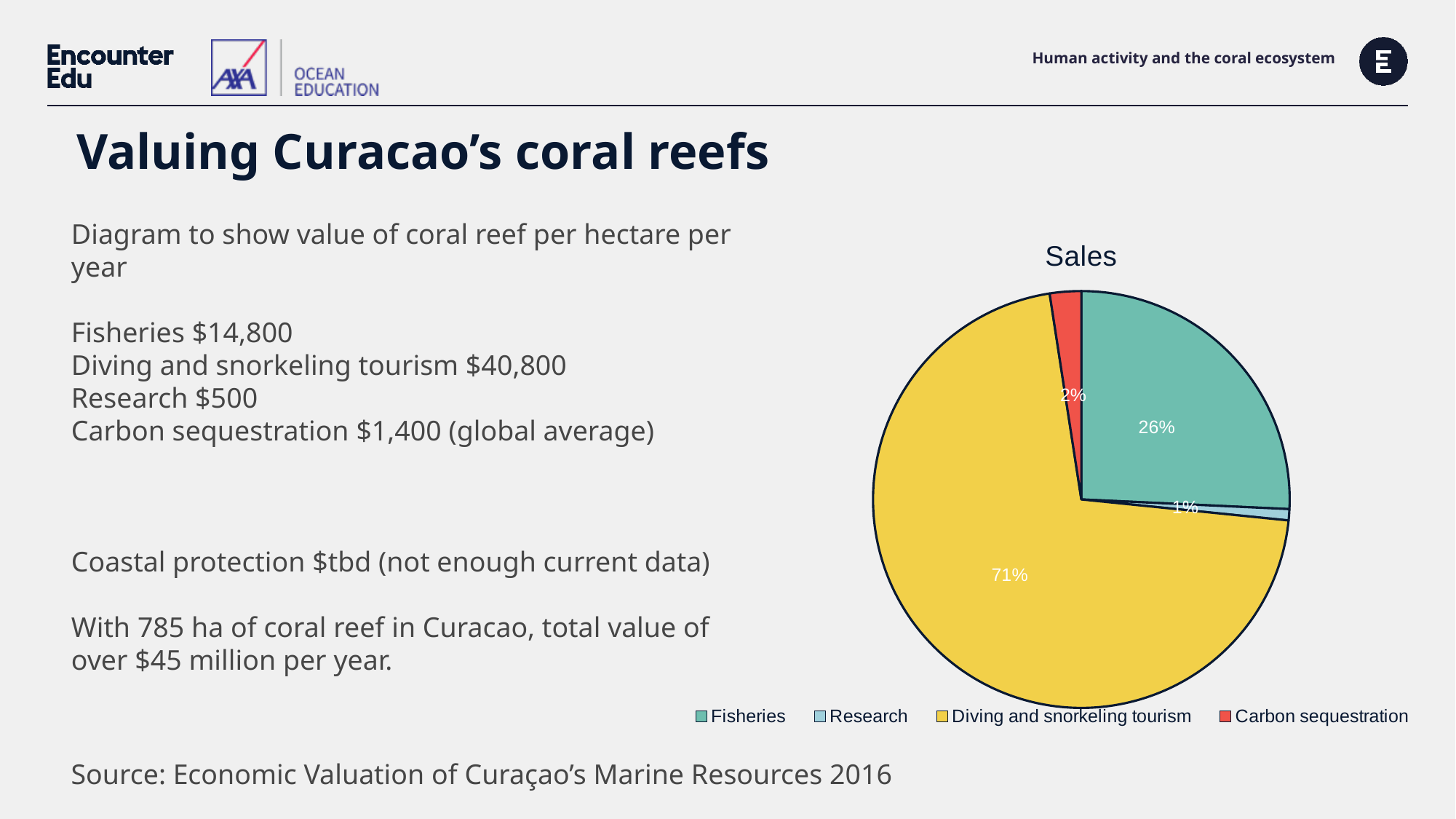
What is the title of the chart? Sales What percentage share does the Fisheries slice have? 26% How many categories does the legend list? 4 Which slice is larger, Fisheries or Carbon sequestration? Fisheries What colour is the Diving and snorkeling tourism slice? yellow What percentage share does the Research slice have? 1% What is the difference in percentage points between the Diving and snorkeling tourism slice and the Fisheries slice? 45 What kind of chart is shown on the slide? pie chart What percentage share does the Carbon sequestration slice have? 2% What percentage share does the Diving and snorkeling tourism slice have? 71% Which category has the largest slice of the pie? Diving and snorkeling tourism Which category has the smallest slice of the pie? Research